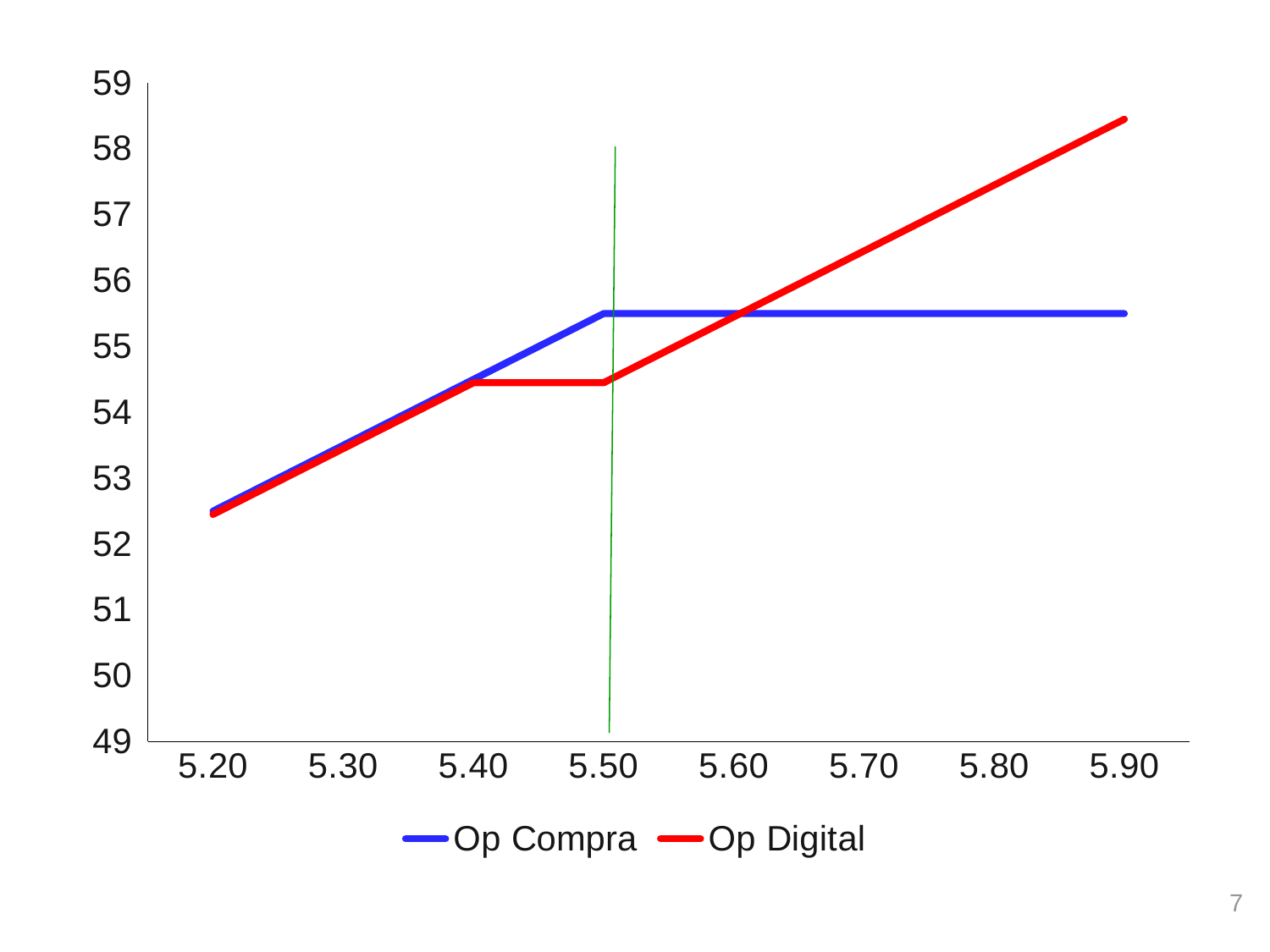
Which series is drawn in blue? Op Compra Is the value for Op Compra at 5.20 greater or less than 53? less What kind of chart is shown on the slide? line chart Does the Op Digital line rise or fall from 5.50 to 5.90? rise Which series is drawn in red? Op Digital At 5.90, which series has the higher value, Op Compra or Op Digital? Op Digital How many series does the legend list? 2 At 5.50, which series has the higher value, Op Compra or Op Digital? Op Compra Is the value for Op Digital at 5.50 greater or less than 55? less Is the value for Op Digital at 5.90 greater or less than 58? greater